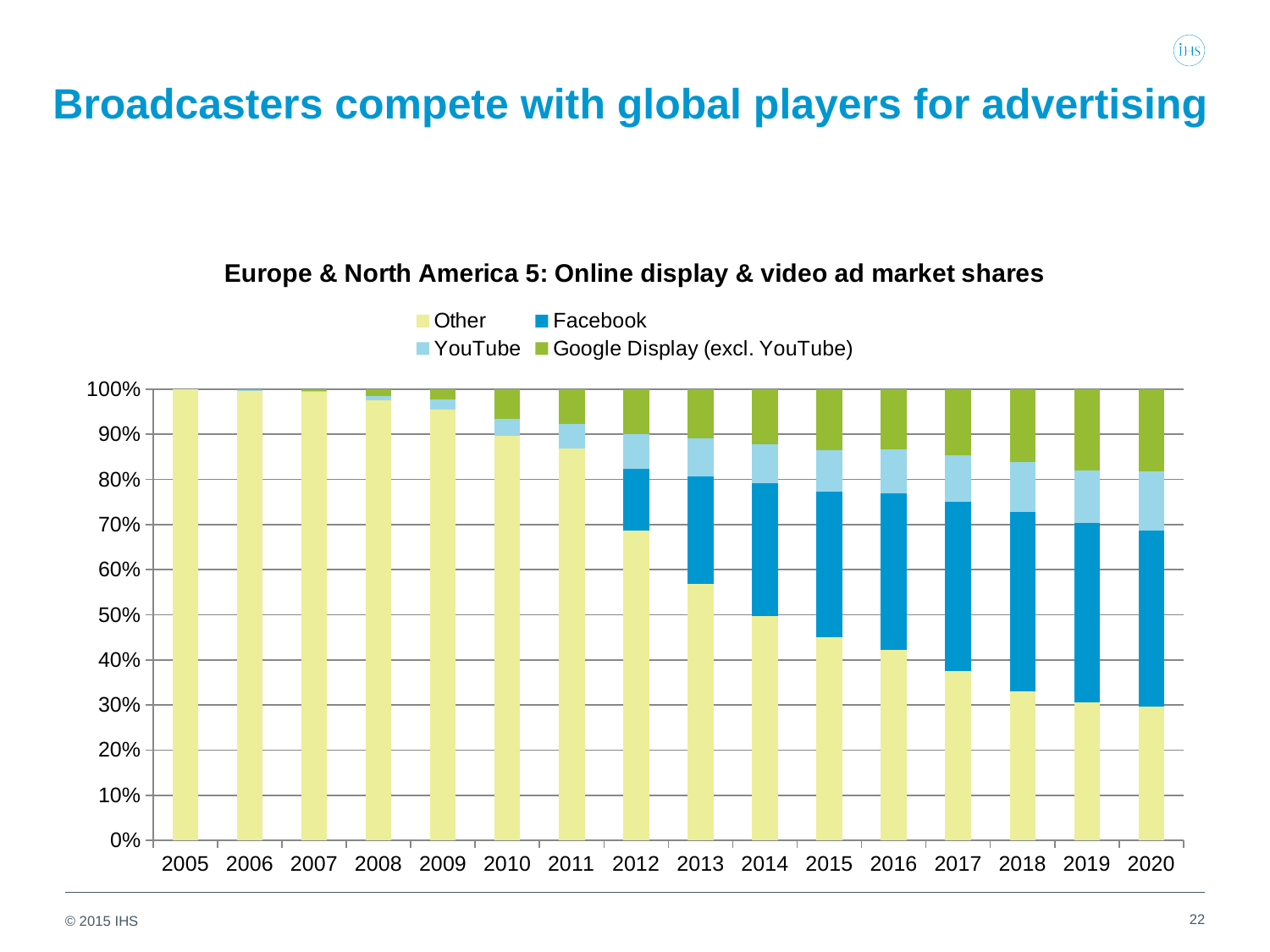
How many series does the legend list? 4 Is the share for Other in 2012 greater or less than 70%? less Does the share for Other rise or fall from 2005 to 2020? Fall What is the title of the chart? Europe & North America 5: Online display & video ad market shares In which year is the share for Other highest? 2005 Is the share for Other in 2017 greater or less than 40%? less What kind of chart is shown on the slide? Stacked bar chart Which series is shown in dark blue? Facebook What is the share for Other in 2005? 100% Is the share for Other in 2013 greater or less than 50%? greater Which is larger in 2020, the share for Other or the share for YouTube? Other How many years are shown on the x axis? 16